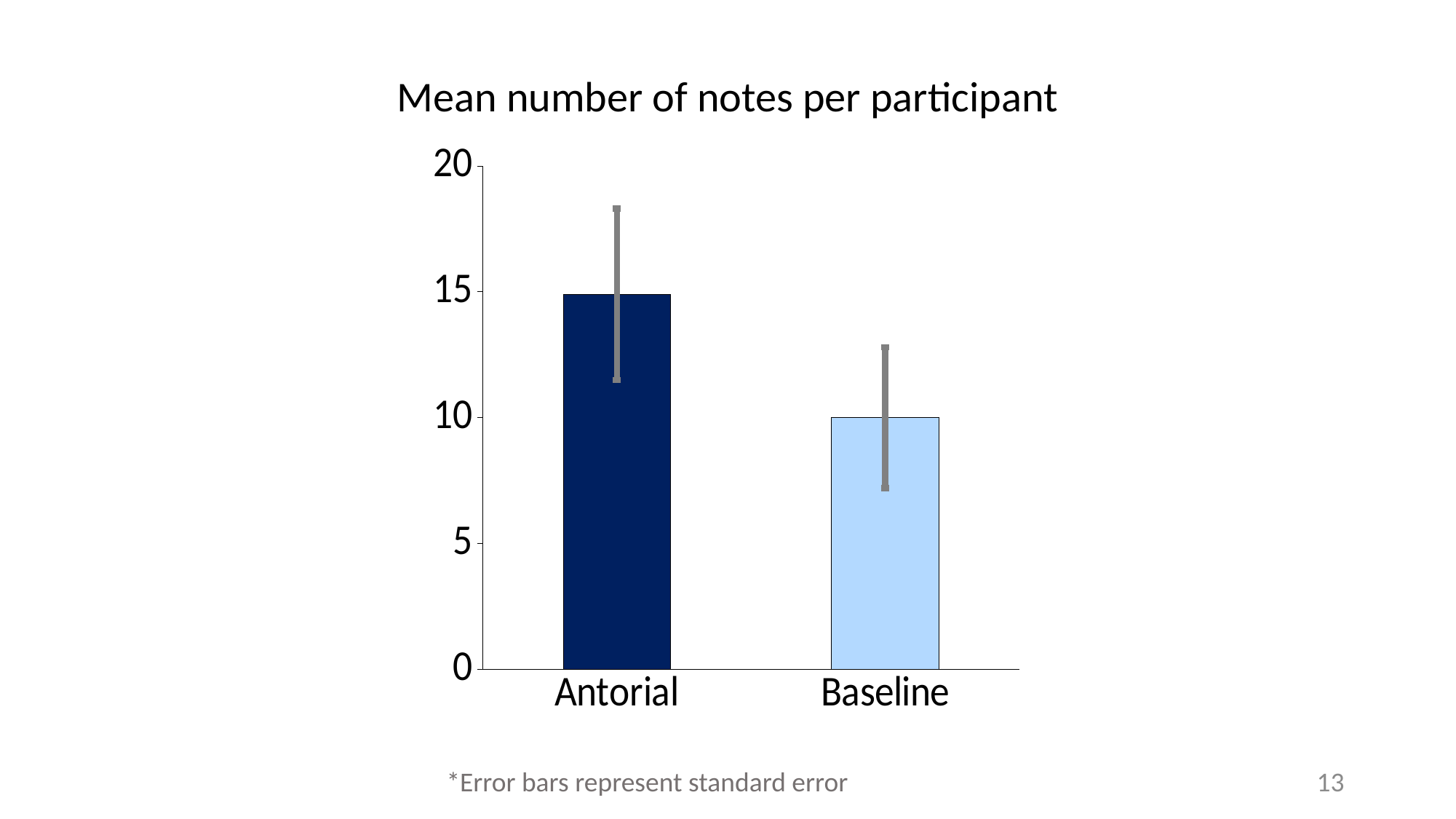
According to the footnote, what do the error bars represent? standard error What is the mean number of notes per participant for Baseline? 10 Which is larger, the value for Antorial or the value for Baseline? Antorial Is the value for Antorial greater or less than 20? less Which category has the lowest mean number of notes per participant? Baseline Is the value for Baseline greater or less than 15? less How many categories are plotted in the chart? 2 Which category has the highest mean number of notes per participant? Antorial What is the title of the chart? Mean number of notes per participant Do the values rise or fall from Antorial to Baseline along the x axis? fall What kind of chart is shown on the slide? bar chart Is the value for Antorial greater or less than 10? greater